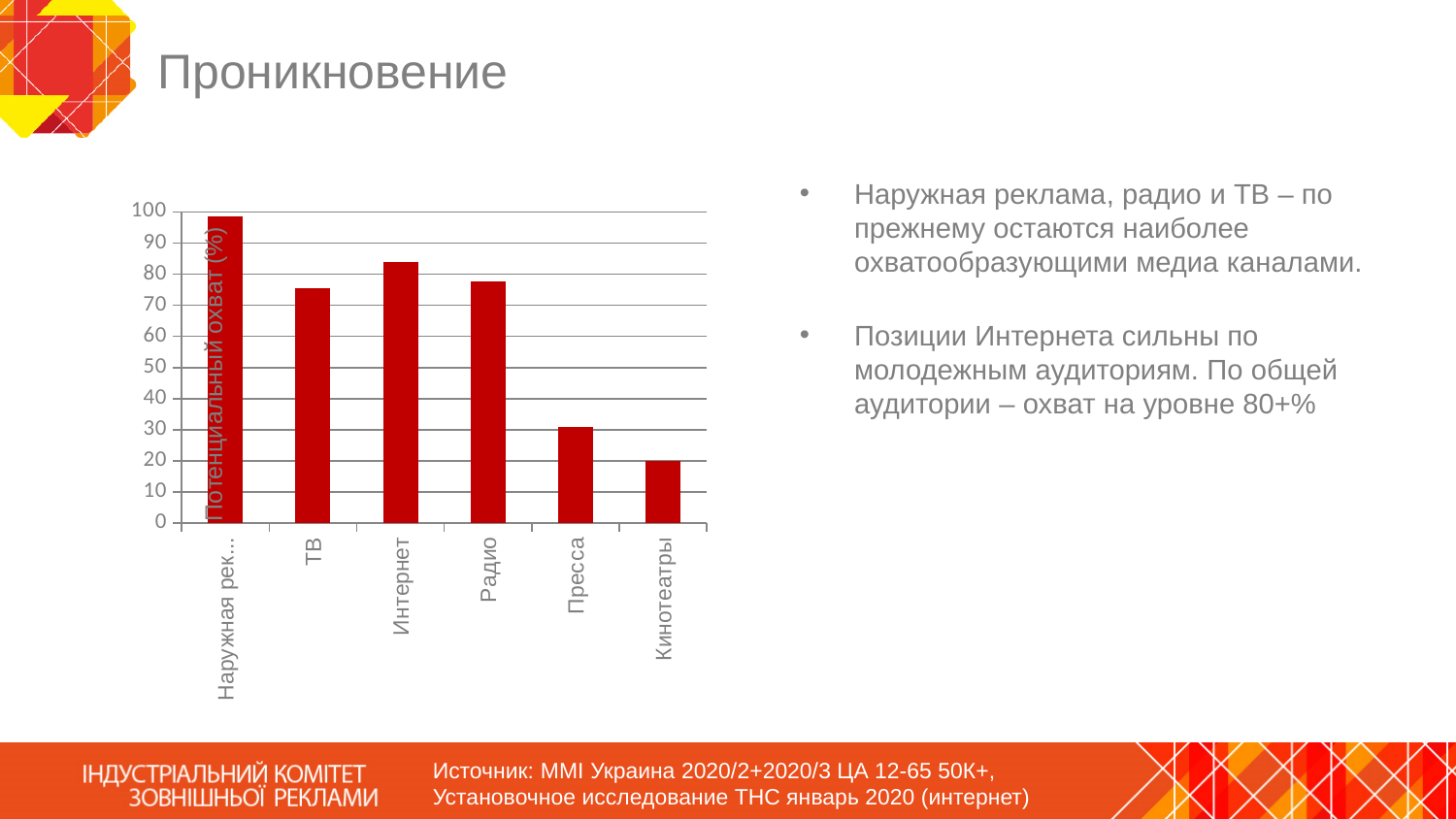
How many categories are plotted on the x axis of the chart? 6 What is the title of the vertical axis of the chart? Потенциальный охват (%) Which has the larger value, Интернет or ТВ? Интернет Is the value for Радио greater or less than 80? less Which has the larger value, Пресса or Кинотеатры? Пресса What kind of chart is shown on the slide? Bar chart Is the value for Кинотеатры greater or less than 30? less Is the value for Пресса greater or less than 40? less Which category has the highest bar in the chart? Наружная рек... (the first bar) Which category has the lowest bar in the chart? Кинотеатры